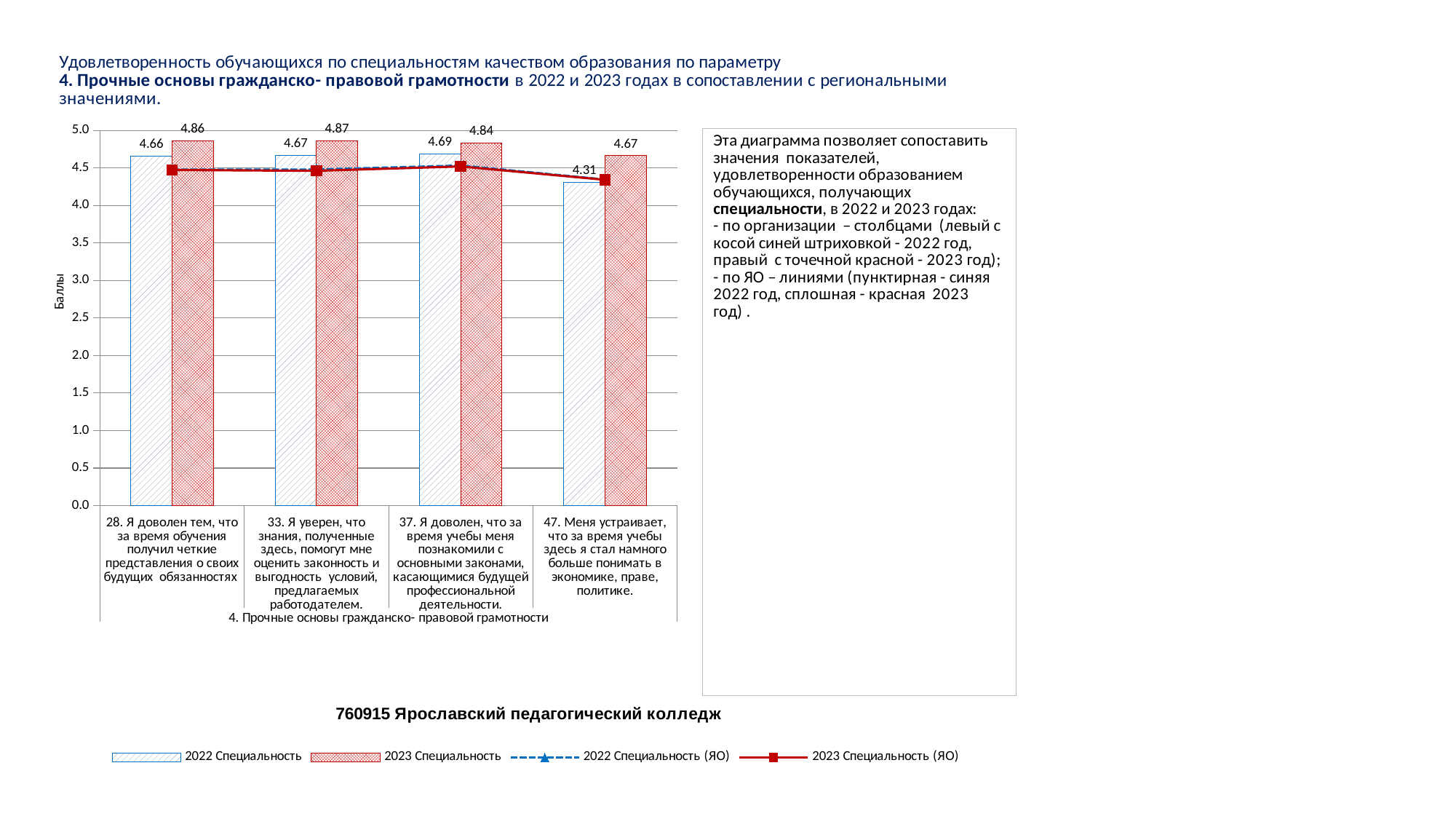
Which item has the lowest 2022 Специальность bar? 47. Меня устраивает, что за время учебы здесь я стал намного больше понимать в экономике, праве, политике. How many items (categories) are shown on the x axis? 4 What is the difference between the 2023 and 2022 Специальность bars for item 47? 0.36 How many series does the legend list? 4 What is the value of the 2022 Специальность bar for item 47 (Меня устраивает, что за время учебы здесь я стал намного больше понимать в экономике, праве, политике)? 4.31 Which item has the highest 2023 Специальность bar? 33. Я уверен, что знания, полученные здесь, помогут мне оценить законность и выгодность условий, предлагаемых работодателем. What is the value of the 2023 Специальность bar for item 28 (Я доволен тем, что за время обучения получил четкие представления о своих будущих обязанностях)? 4.86 For item 47, which bar is larger: 2022 Специальность or 2023 Специальность? 2023 Специальность What is the difference between the 2023 and 2022 Специальность bars for item 28? 0.20 Is the 2023 Специальность (ЯО) line value for item 47 greater or less than 4.5? less What is the value of the 2022 Специальность bar for item 37? 4.69 What is the title of the vertical axis? Баллы